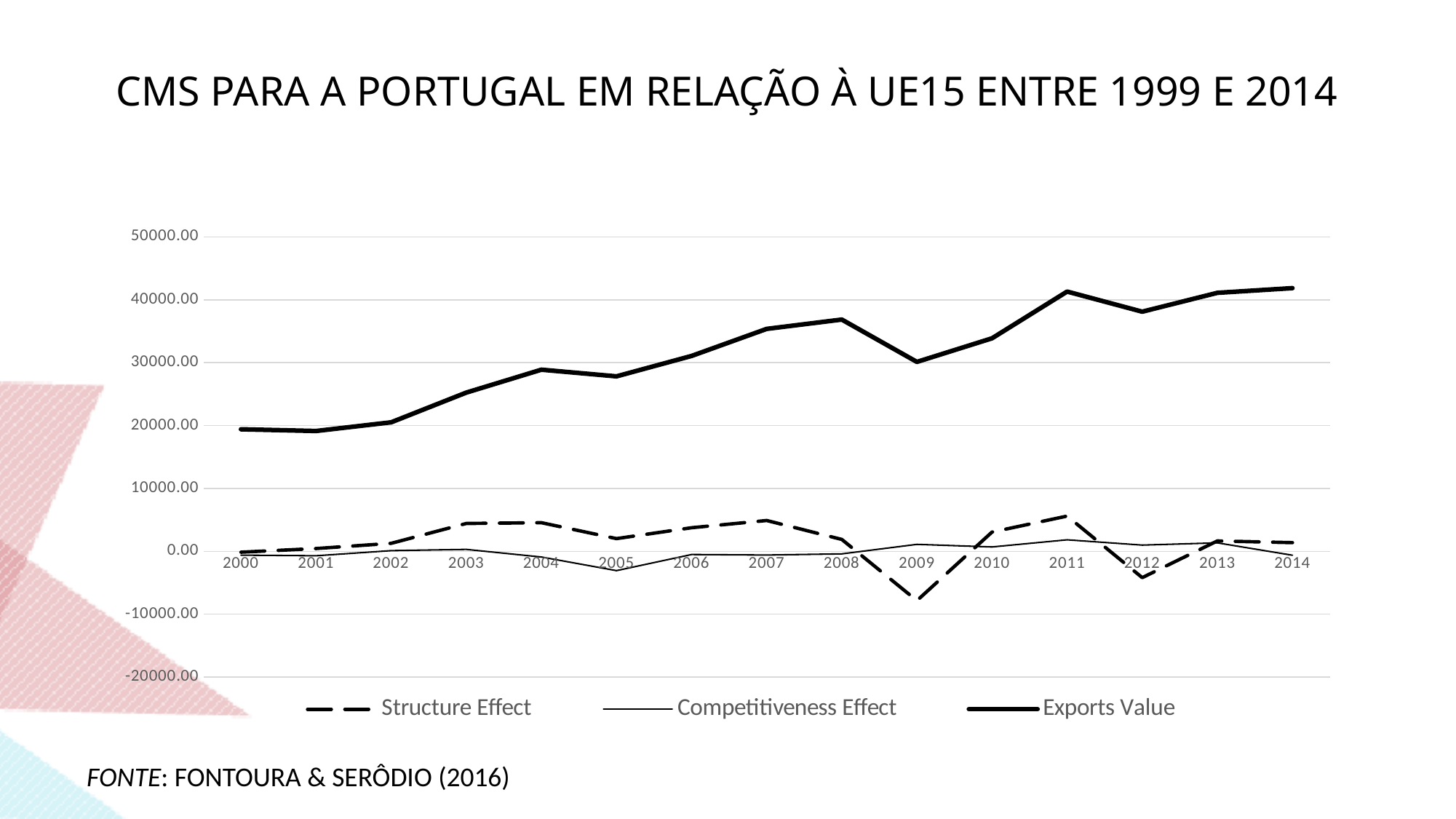
Is the Exports Value for 2014 greater or less than 40000.00? greater What is the title of the slide containing the chart? CMS PARA A PORTUGAL EM RELAÇÃO À UE15 ENTRE 1999 E 2014 Which series is drawn with a dashed line? Structure Effect What kind of chart is shown on the slide? line chart Is the Exports Value for 2000 greater or less than 20000.00? less Does the Exports Value series generally rise or fall from 2000 to 2014? rise Is the Exports Value for 2005 greater or less than 30000.00? less Which year has the larger Exports Value, 2008 or 2009? 2008 Which year has the larger Structure Effect, 2009 or 2011? 2011 How many years are plotted along the x axis? 15 In which year is the Structure Effect at its lowest? 2009 How many series does the legend list? 3